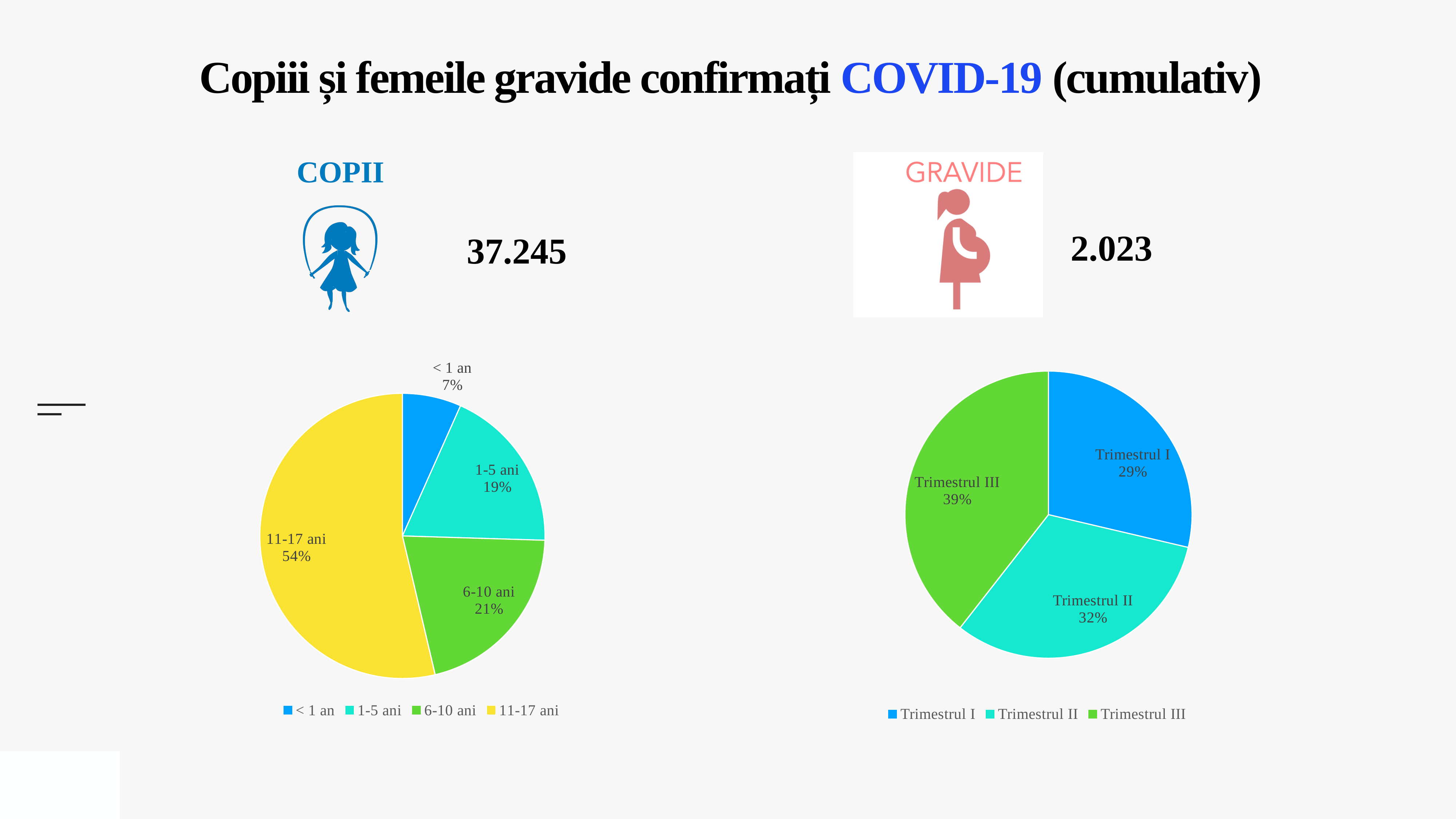
How many entries does the legend of the GRAVIDE pie chart on the right list? 3 In the COPII pie chart on the left, which age group has the largest share? 11-17 ani In the COPII pie chart on the left, what is the difference in percentage points between the 6-10 ani and 1-5 ani slices? 2 In the COPII pie chart on the left, what share is shown for the 11-17 ani slice? 54% In the GRAVIDE pie chart on the right, which trimester has the smallest share? Trimestrul I In the GRAVIDE pie chart on the right, what is the difference in percentage points between Trimestrul III and Trimestrul I? 10 In the COPII pie chart on the left, how many age groups are shown? 4 In the GRAVIDE pie chart on the right, what share is shown for Trimestrul II? 32% What kind of chart is used on the right side of the slide for GRAVIDE? Pie chart In the COPII pie chart on the left, which age group has the smallest share? < 1 an In the COPII pie chart on the left, what share is shown for the < 1 an slice? 7% In the GRAVIDE pie chart on the right, which trimester has the largest share? Trimestrul III